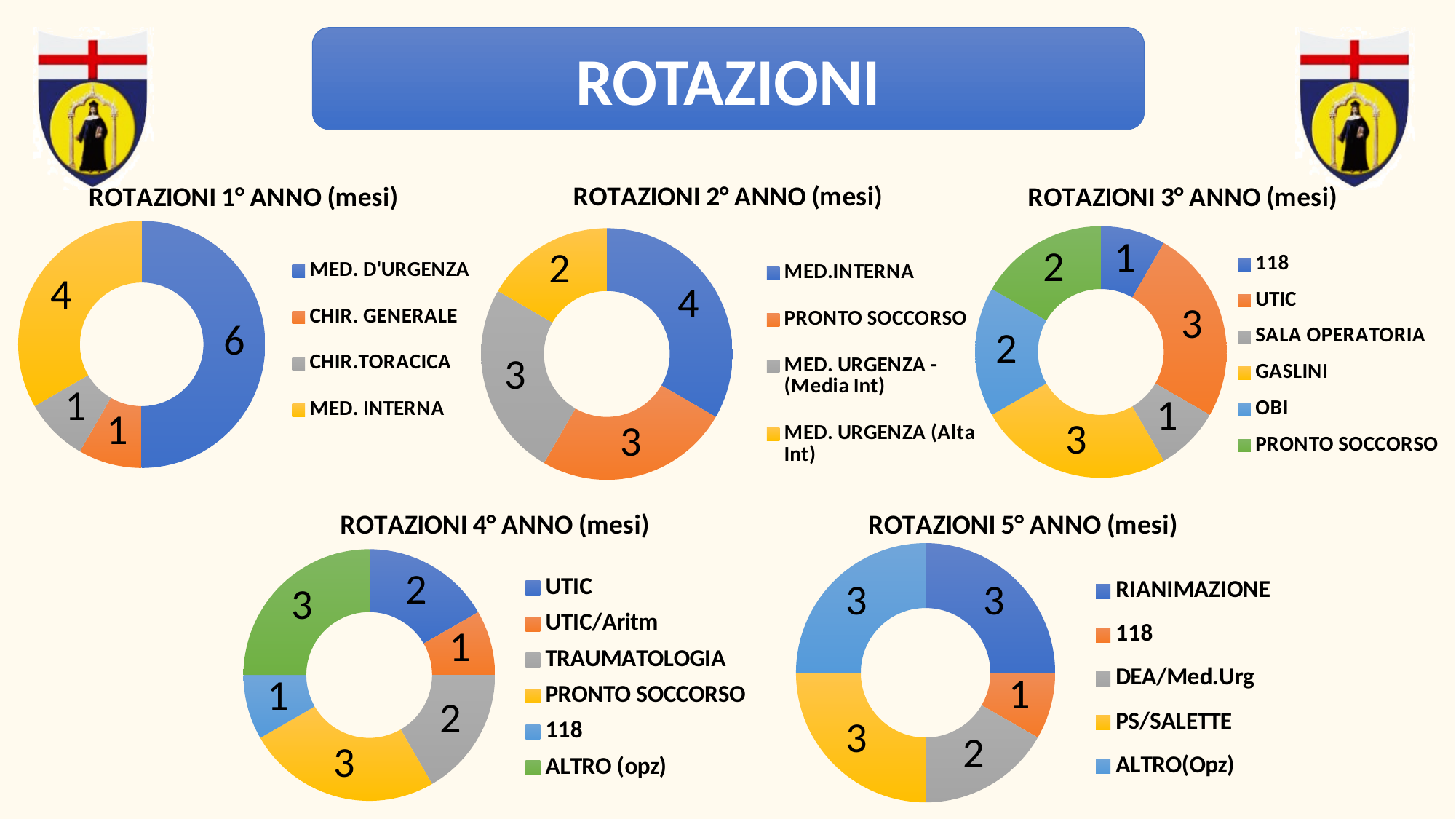
In the ROTAZIONI 3° ANNO (mesi) chart, what is the value for OBI? 2 In the ROTAZIONI 1° ANNO (mesi) chart, which category has the highest value? MED. D'URGENZA In the ROTAZIONI 2° ANNO (mesi) chart, what is the value for MED. URGENZA (Alta Int)? 2 In the ROTAZIONI 1° ANNO (mesi) chart, what share of the total does MED. D'URGENZA represent? 50% In the ROTAZIONI 3° ANNO (mesi) chart, how many categories are shown? 6 In the ROTAZIONI 1° ANNO (mesi) chart, what is the value for MED. D'URGENZA? 6 In the ROTAZIONI 3° ANNO (mesi) chart, which is larger, UTIC or 118? UTIC In the ROTAZIONI 4° ANNO (mesi) chart, what is the total of all categories? 12 In the ROTAZIONI 5° ANNO (mesi) chart, which category has the lowest value? 118 In the ROTAZIONI 2° ANNO (mesi) chart, what is the difference between MED.INTERNA and MED. URGENZA (Alta Int)? 2 In the ROTAZIONI 4° ANNO (mesi) chart, what is the value for TRAUMATOLOGIA? 2 What kind of chart is the ROTAZIONI 5° ANNO (mesi) chart? Doughnut chart